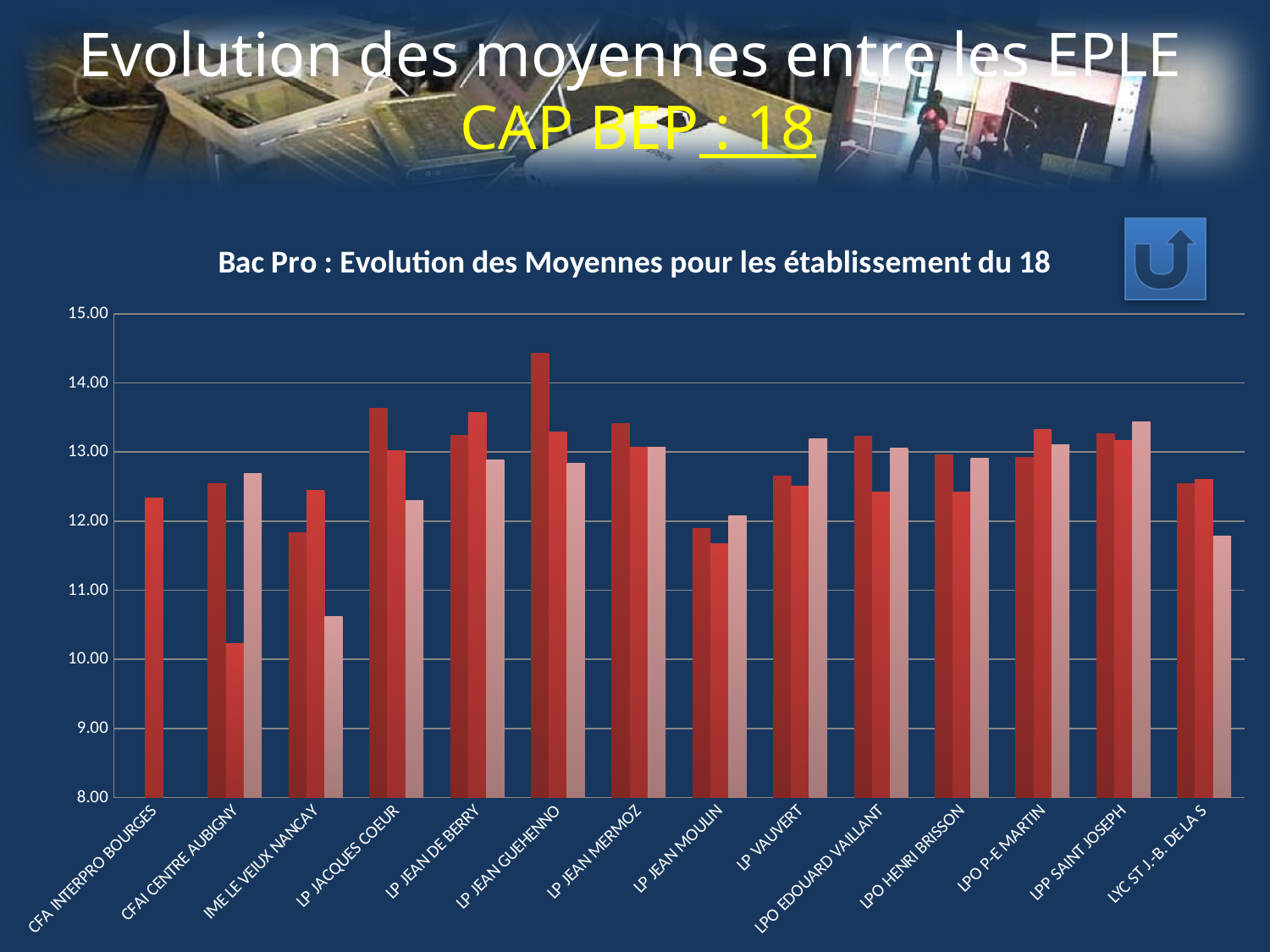
Is the shortest bar for IME LE VIEUX NANCAY greater or less than 11.00? less Which establishment has the shortest bar in the chart? CFAI CENTRE AUBIGNY What is the title of the chart? Bac Pro : Evolution des Moyennes pour les établissement du 18 Is the shortest bar for CFAI CENTRE AUBIGNY greater or less than 11.00? less Which establishment has the tallest bar in the chart? LP JEAN GUEHENNO What kind of chart is shown on the slide? bar chart What is the lowest value shown on the vertical axis of the chart? 8.00 Is the value of the single bar for CFA INTERPRO BOURGES greater or less than 12.00? greater Which is taller: the first (darkest) bar for LP JEAN GUEHENNO or the first (darkest) bar for LP JACQUES COEUR? LP JEAN GUEHENNO How many establishments (categories) are shown on the x axis of the chart? 14